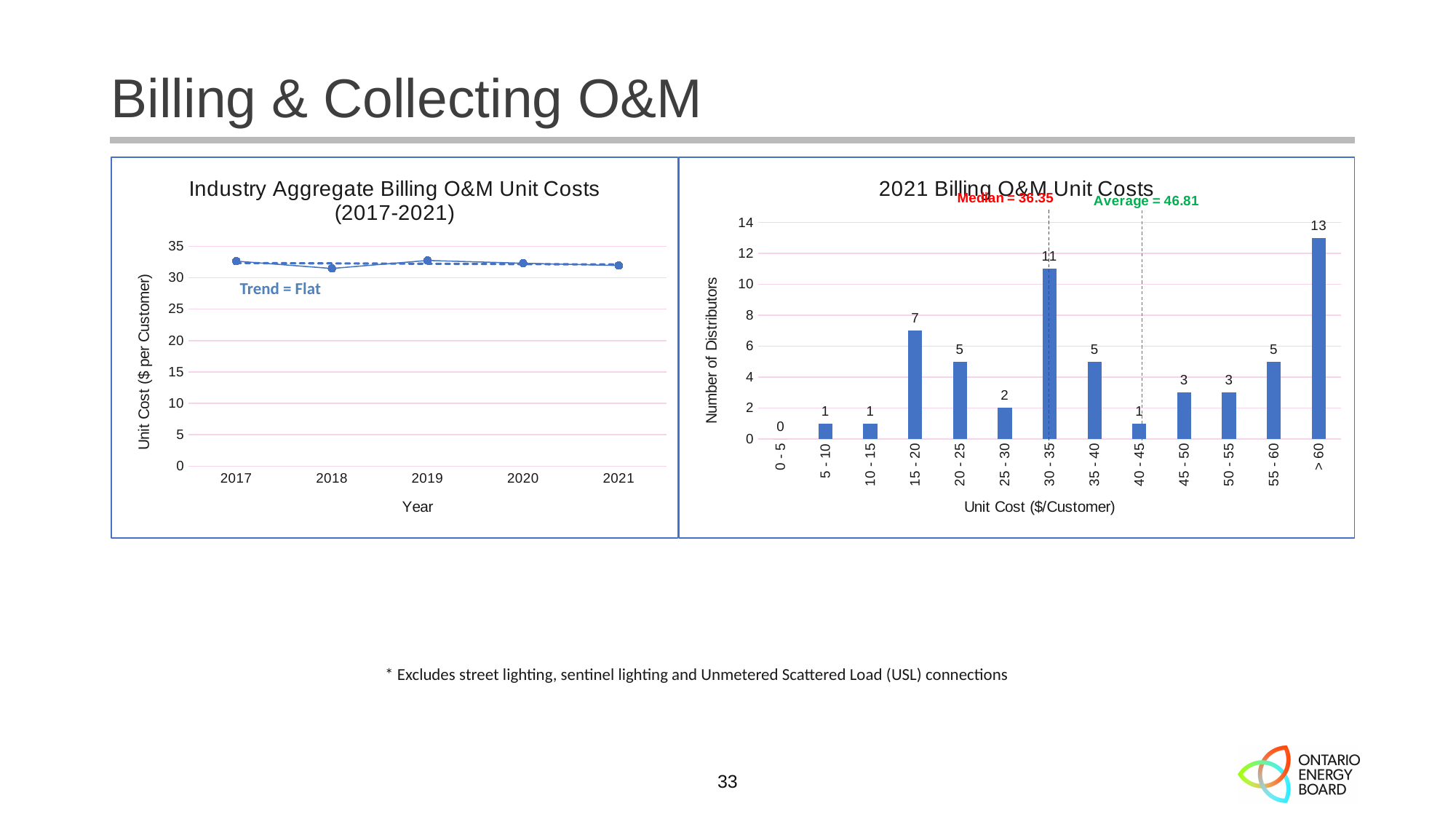
In the 2021 Billing O&M Unit Costs chart, how many unit cost bins are shown on the x axis? 13 In the 2021 Billing O&M Unit Costs chart, what is the difference between the number of distributors in the > 60 bin and the 30 - 35 bin? 2 In the Industry Aggregate Billing O&M Unit Costs (2017-2021) chart, how many years are plotted? 5 What kind of chart is the Industry Aggregate Billing O&M Unit Costs (2017-2021) chart? line chart In the 2021 Billing O&M Unit Costs chart, how many distributors are in the 15 - 20 bin? 7 In the 2021 Billing O&M Unit Costs chart, what median value is annotated? 36.35 In the 2021 Billing O&M Unit Costs chart, how many distributors are in the 30 - 35 unit cost bin? 11 In the 2021 Billing O&M Unit Costs chart, which unit cost bin has the fewest distributors? 0 - 5 In the 2021 Billing O&M Unit Costs chart, which unit cost bin has the most distributors? > 60 In the 2021 Billing O&M Unit Costs chart, which bin has more distributors, 20 - 25 or 25 - 30? 20 - 25 In the 2021 Billing O&M Unit Costs chart, what average value is annotated? 46.81 In the Industry Aggregate Billing O&M Unit Costs (2017-2021) chart, is the value for 2018 greater or less than 30? greater